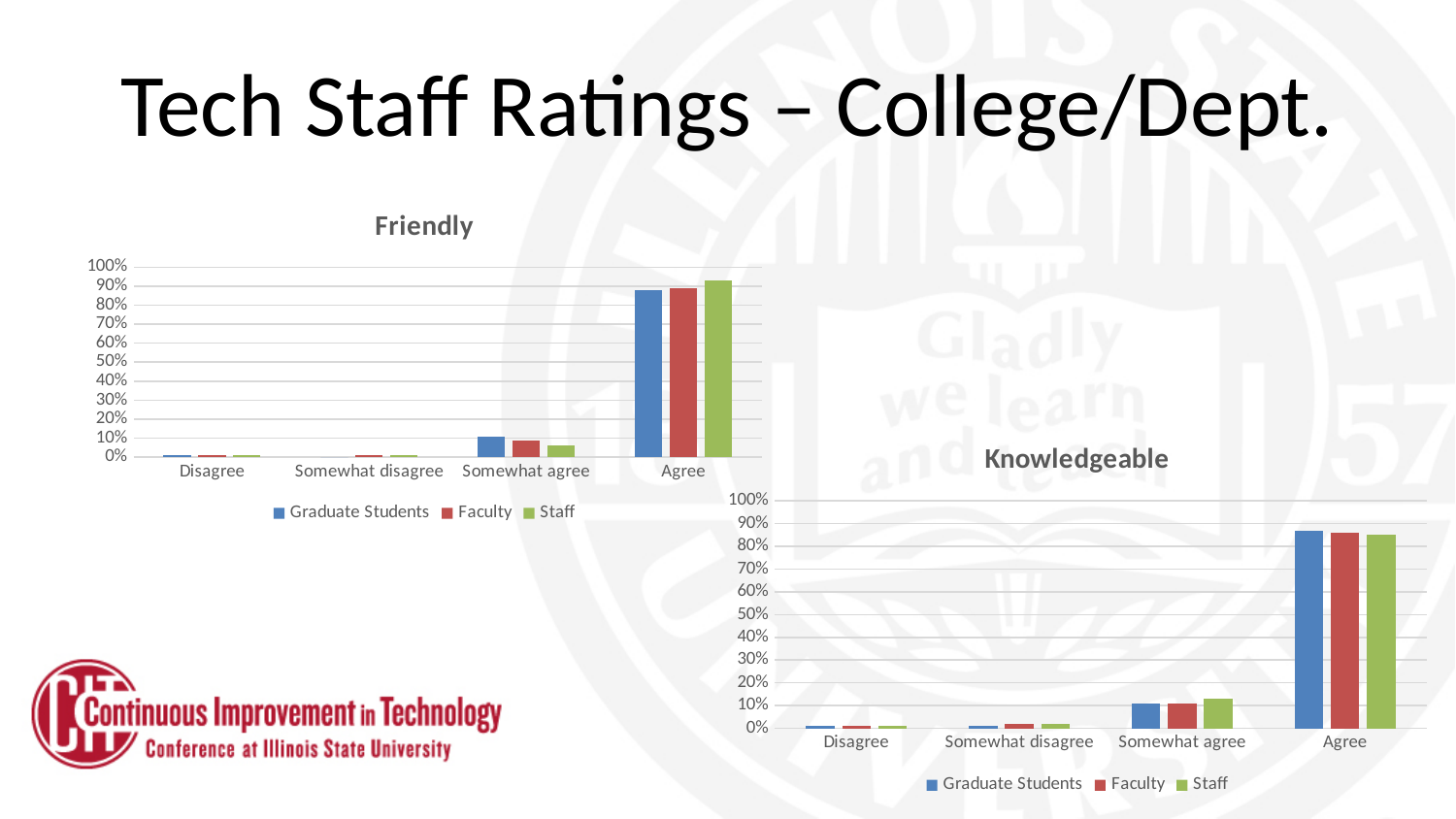
In the Knowledgeable chart, is the value for Faculty in the Disagree category greater or less than 10%? less In the Knowledgeable chart, which series has the highest value in the Somewhat agree category? Staff In the Friendly chart, is the value for Graduate Students in the Somewhat agree category greater or less than 20%? less How many series does the legend of the Friendly chart list? 3 In the Friendly chart, which series has the lowest value in the Somewhat agree category? Staff What kind of chart is the Knowledgeable chart? bar chart In the Friendly chart, which is larger in the Somewhat agree category: Graduate Students or Staff? Graduate Students In the Friendly chart, which series has the highest value in the Agree category? Staff What are the titles of the two charts on the slide? Friendly and Knowledgeable In the Friendly chart, is the value for Staff in the Agree category greater or less than 80%? greater How many categories are shown on the x axis of the Friendly chart? 4